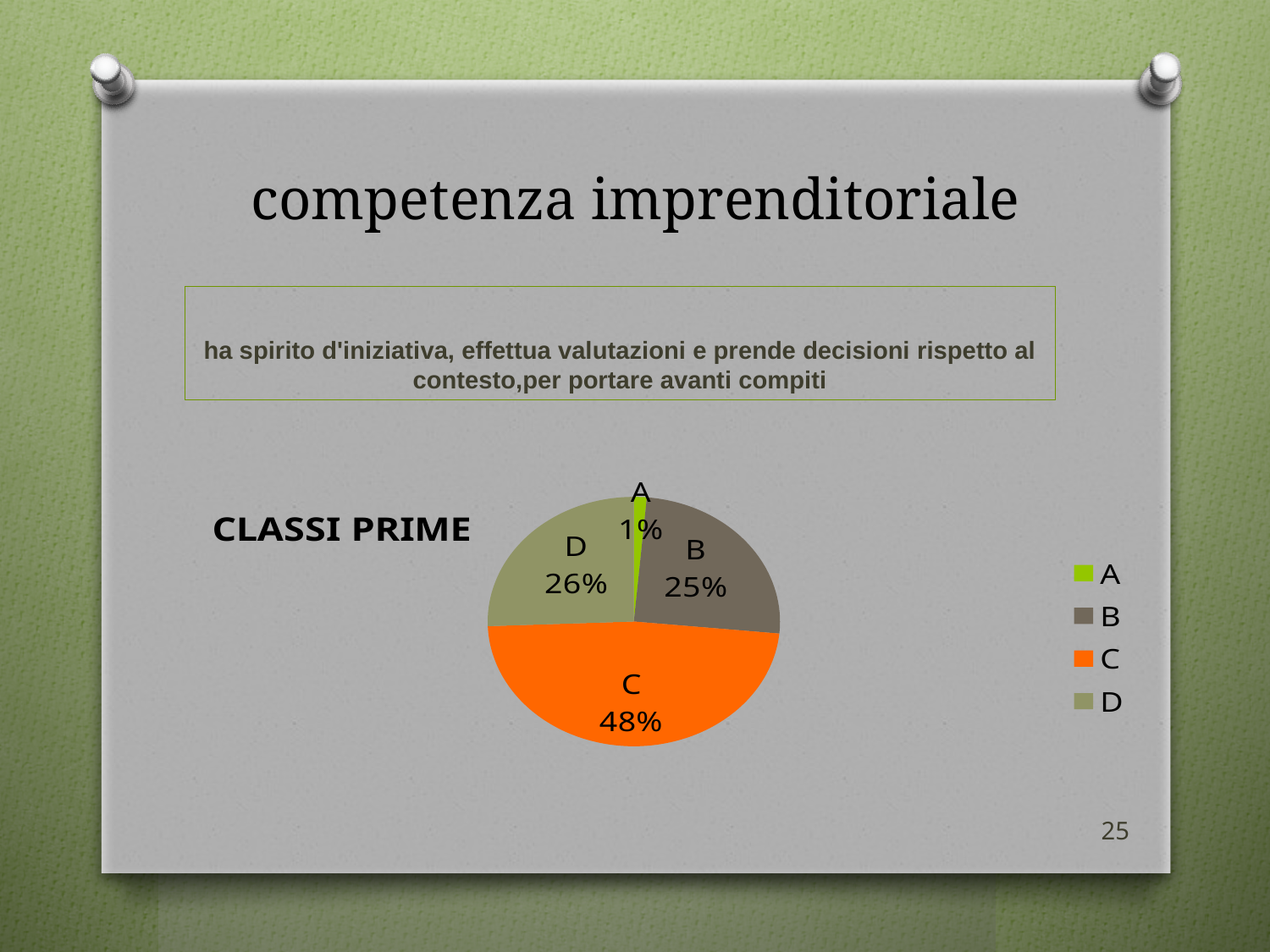
What percentage does slice A represent? 1% Which is larger, slice C or slice B? C How many entries does the legend list? 4 What percentage does slice B represent? 25% What kind of chart is shown on the slide? pie chart Which category has the largest share of the pie? C What colour is slice C in the pie chart? orange What is the difference in percentage points between slice C and slice D? 22 What percentage does slice D represent? 26% How many slices does the pie chart have? 4 What percentage does slice C represent? 48% Which category has the smallest share of the pie? A